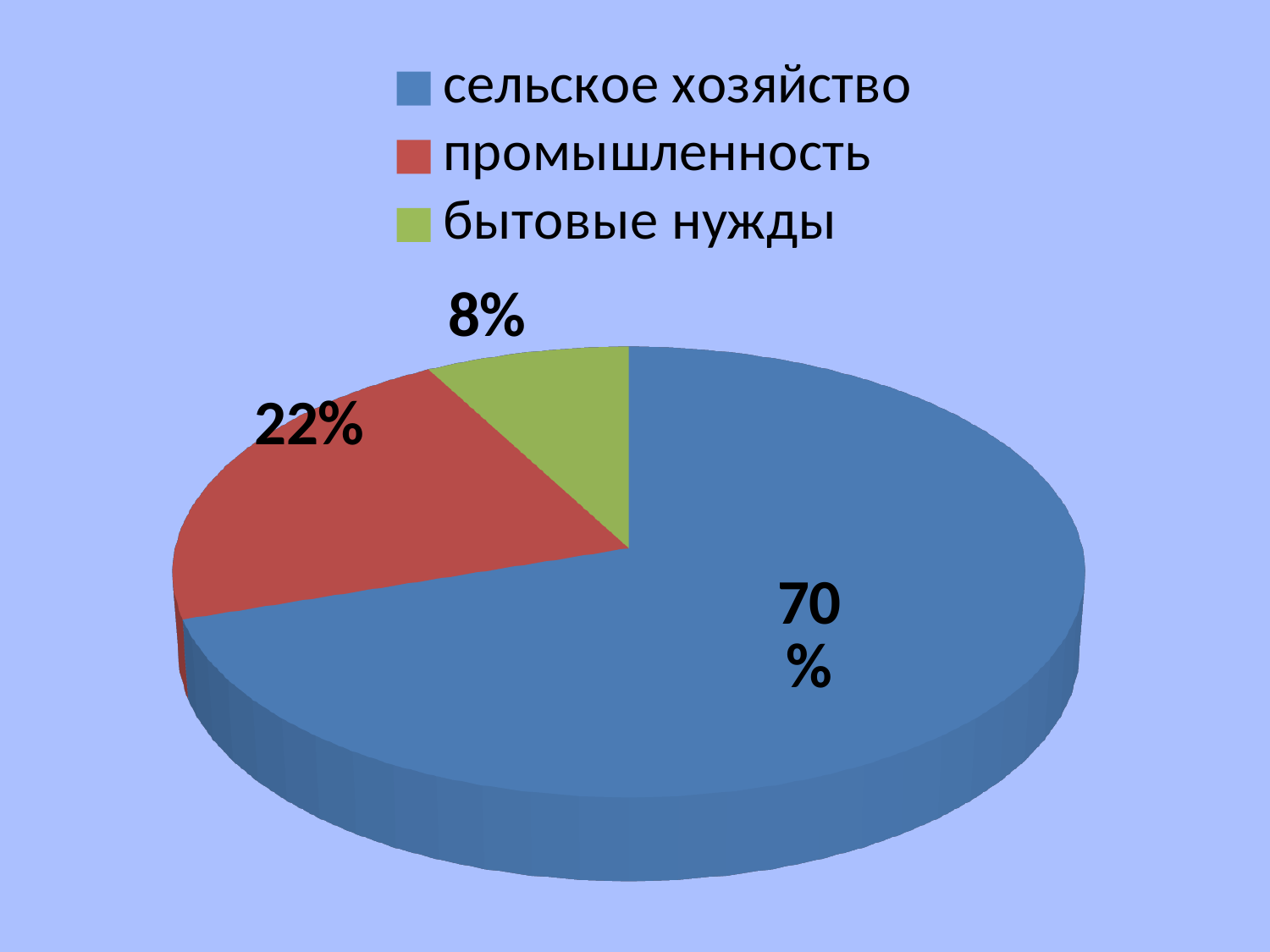
What share of the pie does промышленность take? 22% What share of the pie does бытовые нужды take? 8% What share of the pie does сельское хозяйство take? 70% How many categories does the pie chart have? 3 Which category has the smallest slice of the pie? бытовые нужды What is the difference between the shares of сельское хозяйство and промышленность? 48% What kind of chart is shown on the slide? pie chart What is the difference between the shares of промышленность and бытовые нужды? 14% How many entries does the legend list? 3 Which is larger, the share of промышленность or the share of бытовые нужды? промышленность Which category has the largest slice of the pie? сельское хозяйство What colour is the slice for промышленность? red